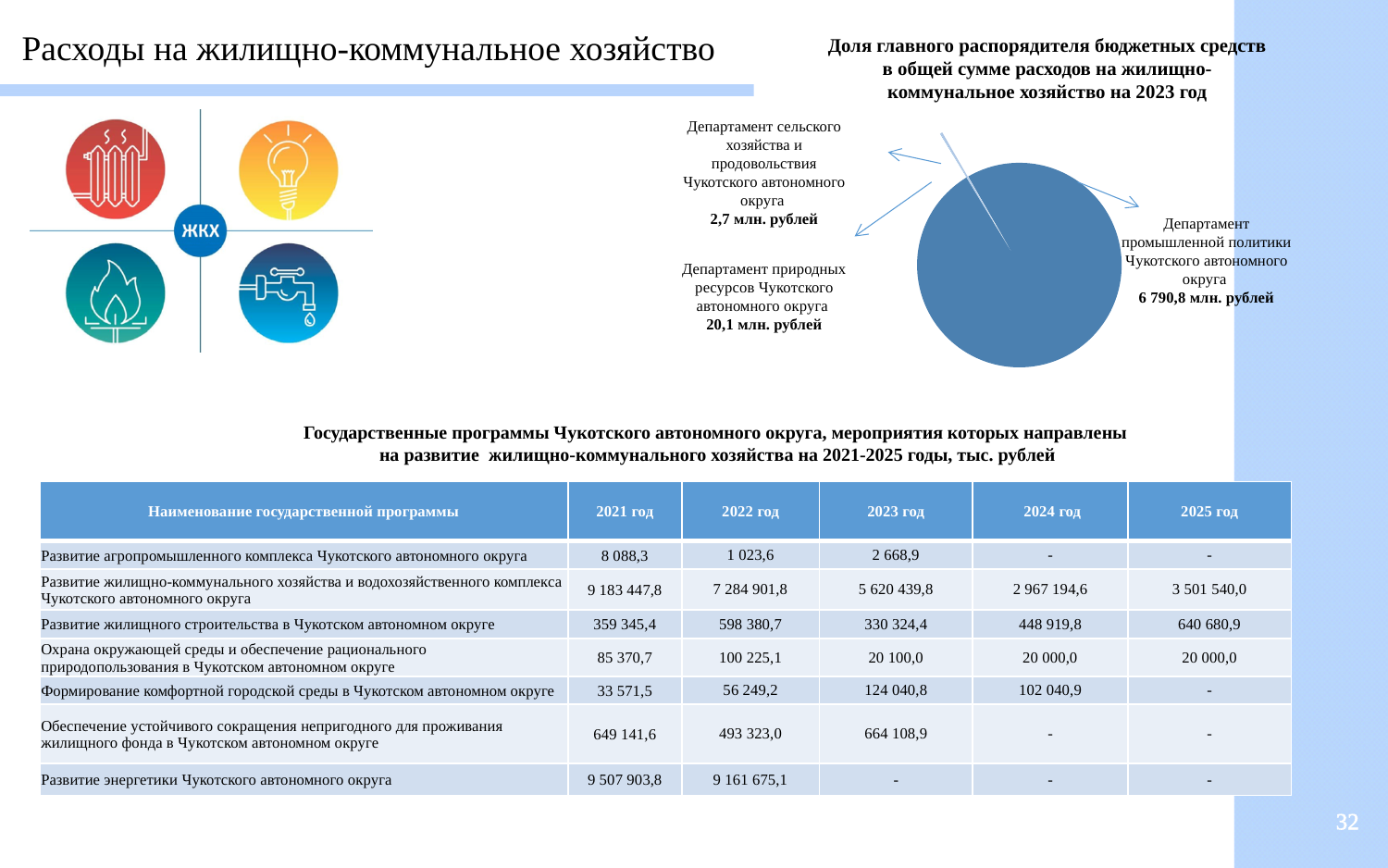
In the pie chart, what is the difference between the values for Департамент природных ресурсов and Департамент сельского хозяйства и продовольствия? 17,4 млн. рублей In the pie chart, what is the difference between the values for Департамент промышленной политики and Департамент природных ресурсов? 6 770,7 млн. рублей In the pie chart, which is larger: the value for Департамент природных ресурсов or for Департамент сельского хозяйства и продовольствия? Департамент природных ресурсов In the pie chart, what is the value for Департамент природных ресурсов Чукотского автономного округа? 20,1 млн. рублей What is the title of the pie chart? Доля главного распорядителя бюджетных средств в общей сумме расходов на жилищно-коммунальное хозяйство на 2023 год What is the total of the three values shown in the pie chart? 6 813,6 млн. рублей In the pie chart, what is the value for Департамент промышленной политики Чукотского автономного округа? 6 790,8 млн. рублей In the pie chart, what is the value for Департамент сельского хозяйства и продовольствия Чукотского автономного округа? 2,7 млн. рублей Which department has the largest slice in the pie chart? Департамент промышленной политики Чукотского автономного округа Which department has the smallest slice in the pie chart? Департамент сельского хозяйства и продовольствия Чукотского автономного округа How many slices (departments) does the pie chart show? 3 What kind of chart is shown in the top right of the slide? pie chart